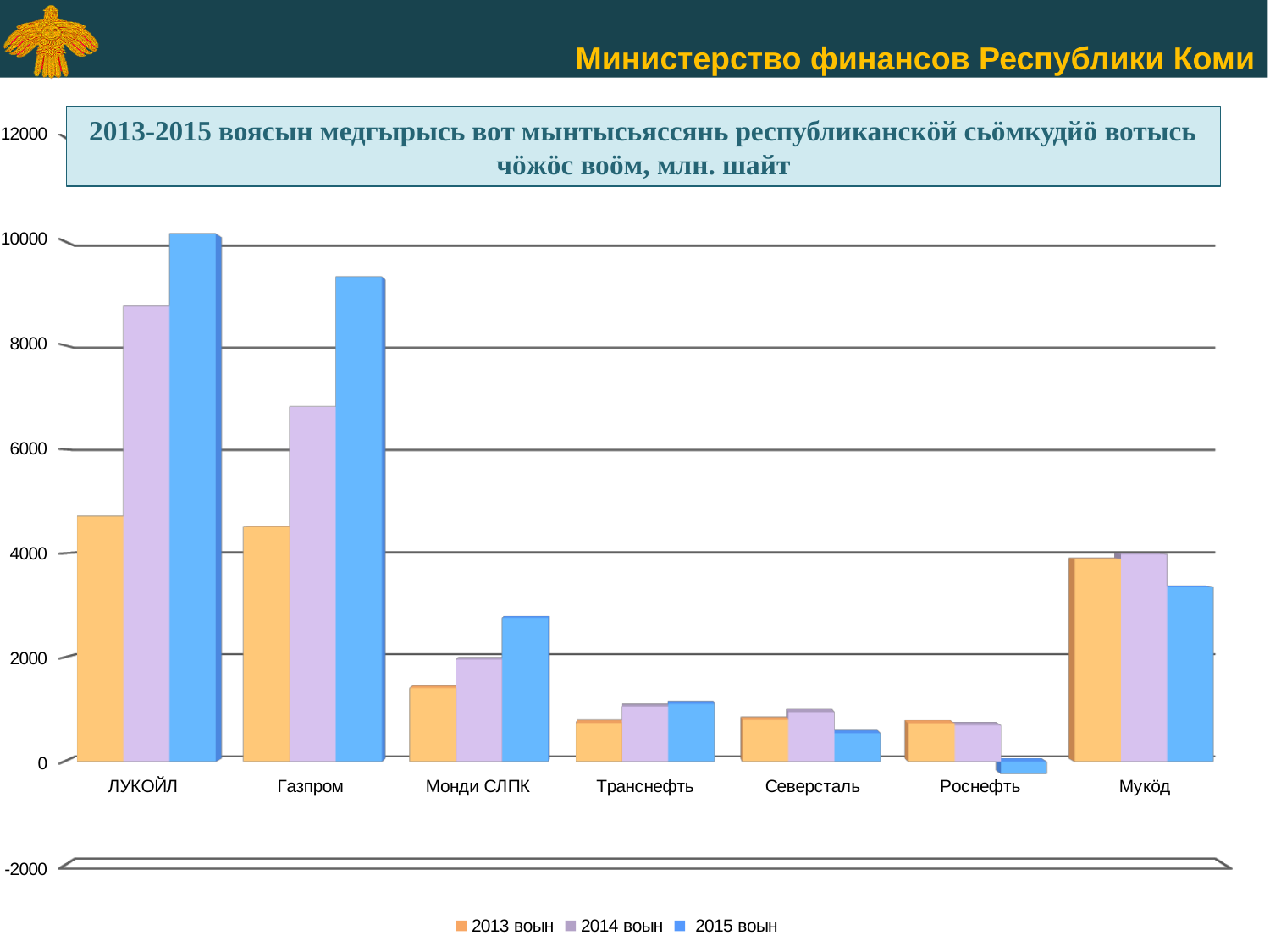
Do the values for ЛУКОЙЛ rise or fall from 2013 воын to 2015 воын? rise Is the 2015 воын value for Роснефть greater or less than 0? less Is the 2014 воын value for Газпром greater or less than 6000? greater Which category has the lowest value for the 2015 воын series? Роснефть How many series does the legend list? 3 Is the 2015 воын value for Монди СЛПК greater or less than 2000? greater What are the three legend entries of the chart? 2013 воын, 2014 воын, 2015 воын Which has the larger 2014 воын value, ЛУКОЙЛ or Газпром? ЛУКОЙЛ How many categories are shown on the x axis? 7 Which category has the highest value for the 2015 воын series? ЛУКОЙЛ What kind of chart is shown on the slide? bar chart